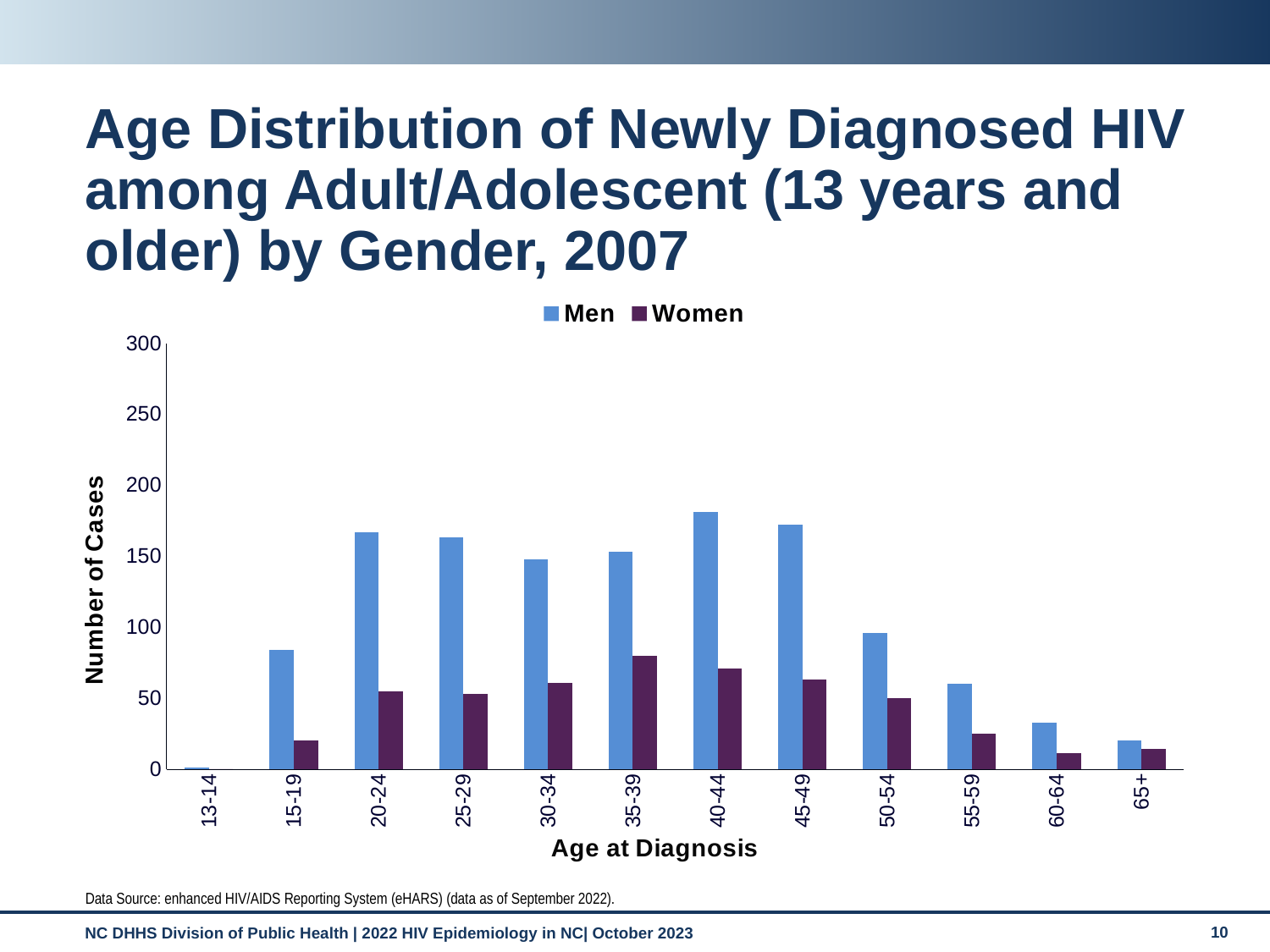
Which age group has the lowest number of cases for Men? 13-14 In the 30-34 age group, which series has more cases, Men or Women? Men How many age groups are shown on the x axis? 12 Is the value for Women in the 15-19 age group greater or less than 50? less Which age group has the highest number of cases for Women? 35-39 Which age group has the highest number of cases for Men? 40-44 Is the value for Men in the 40-44 age group greater or less than 150? greater Is the value for Men in the 50-54 age group greater or less than 100? less What kind of chart is shown on the slide? Bar chart How many series does the legend list? 2 Do the values for Women rise or fall from the 35-39 age group to the 65+ age group? Fall